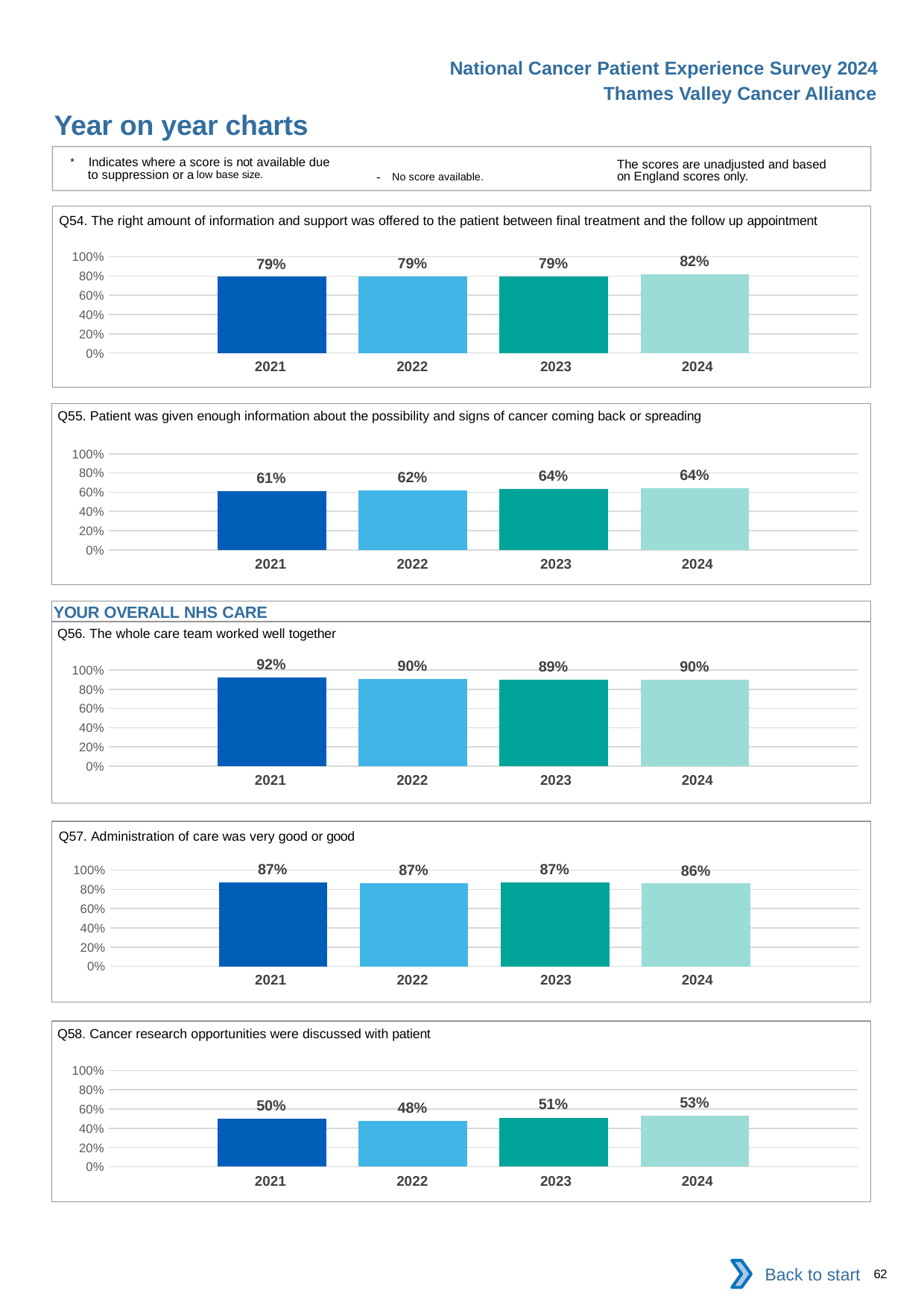
How many years are shown in the Q57 chart? 4 In the Q55 chart, what is the value for 2021? 61% In the Q55 chart, do the values rise or fall from 2021 to 2024? Rise In the Q56 chart, which year has the highest value? 2021 What is the section heading printed above the Q56 chart? YOUR OVERALL NHS CARE In the Q54 chart, what is the value for 2024? 82% What kind of chart is the Q56 chart? Bar chart In the Q58 chart, which year has the lowest value? 2022 In the Q58 chart, what is the difference between the 2024 value and the 2022 value? 5% In the Q55 chart, what is the difference between the 2023 value and the 2021 value? 3% In the Q57 chart, which is larger, the value for 2023 or the value for 2024? 2023 In the Q56 chart, what is the value for 2023? 89%